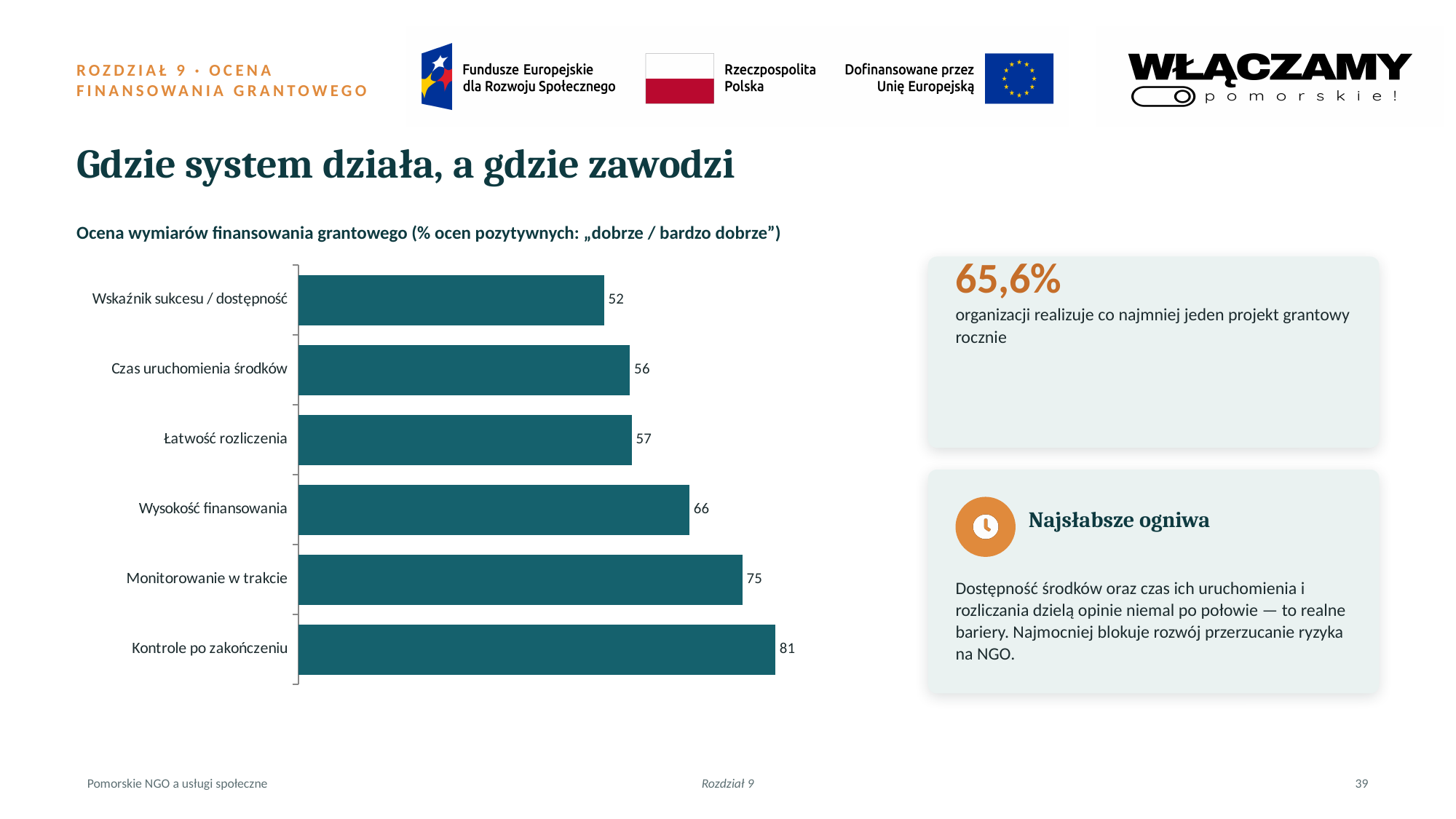
What is the difference between the values for Kontrole po zakończeniu and Wskaźnik sukcesu / dostępność? 29 What is the value for Kontrole po zakończeniu? 81 Which category has the lowest value? Wskaźnik sukcesu / dostępność What is the difference between the values for Monitorowanie w trakcie and Wysokość finansowania? 9 What kind of chart is shown on the slide? Bar chart What is the value for Czas uruchomienia środków? 56 Which is larger, the value for Monitorowanie w trakcie or the value for Łatwość rozliczenia? Monitorowanie w trakcie Which category has the highest value? Kontrole po zakończeniu What is the title of the chart? Ocena wymiarów finansowania grantowego (% ocen pozytywnych: „dobrze / bardzo dobrze”) What colour are the bars in the chart? Dark teal How many categories are shown in the chart? 6 What is the value for Wysokość finansowania? 66